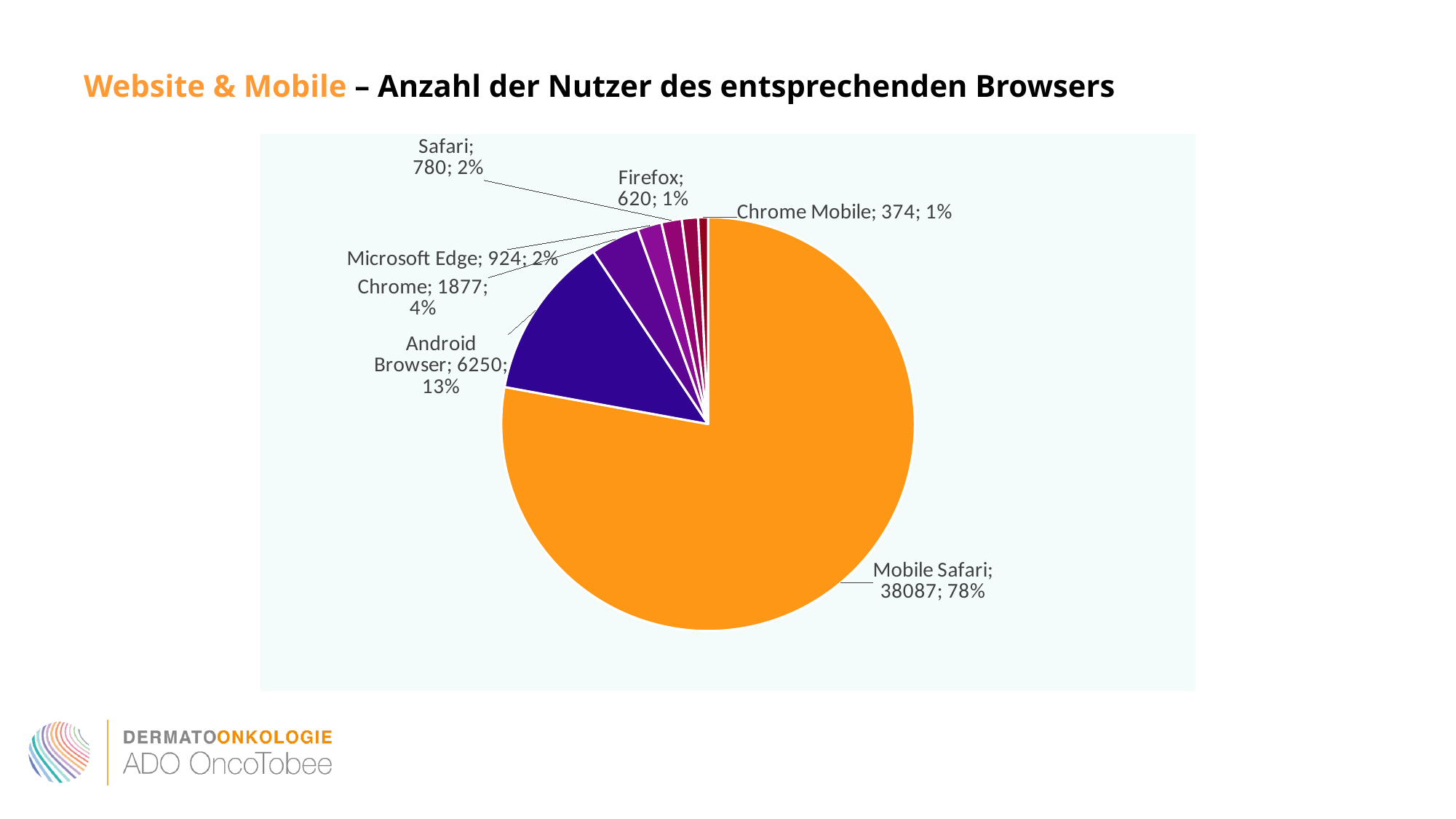
What is the difference in users between Safari and Firefox? 160 Which has more users, Chrome or Android Browser? Android Browser What share of the pie does Chrome have? 4% What share of the pie does Mobile Safari have? 78% How many users does the chart show for Mobile Safari? 38087 How many users does the chart show for Chrome Mobile? 374 Which browser has the most users? Mobile Safari What kind of chart is shown on the slide? pie chart How many users does the chart show for Android Browser? 6250 How many browsers (slices) are shown in the pie chart? 7 How many users does the chart show for Microsoft Edge? 924 Which browser has the fewest users? Chrome Mobile